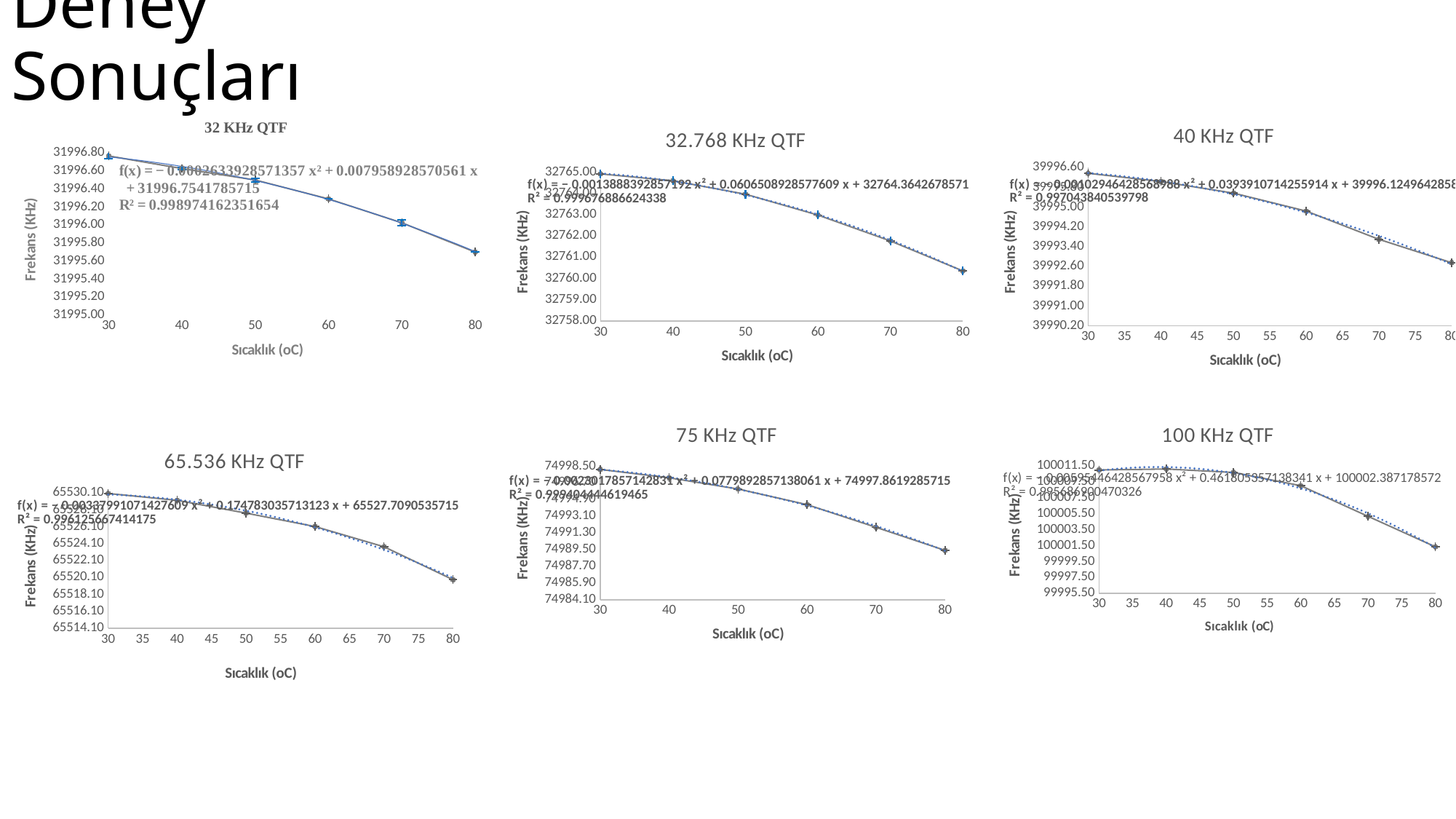
What is the x-axis label of the "100 KHz QTF" chart? Sıcaklık (oC) In the "40 KHz QTF" chart, is the value at 80 greater or less than 39994.20? less In the "40 KHz QTF" chart, do the frequency values rise or fall as temperature increases along the x axis? fall In the "32.768 KHz QTF" chart, is the value at 30 greater or less than 32764.00? greater In the "75 KHz QTF" chart, at which temperature is the frequency highest? 30 How many data points are plotted in the "32.768 KHz QTF" chart? 6 How many charts are shown on the slide? 6 In the "65.536 KHz QTF" chart, is the value at 80 greater or less than 65522.10? less What kind of chart is the "32 KHz QTF" chart? line chart In the "32 KHz QTF" chart, which temperature has the larger frequency value, 30 or 80? 30